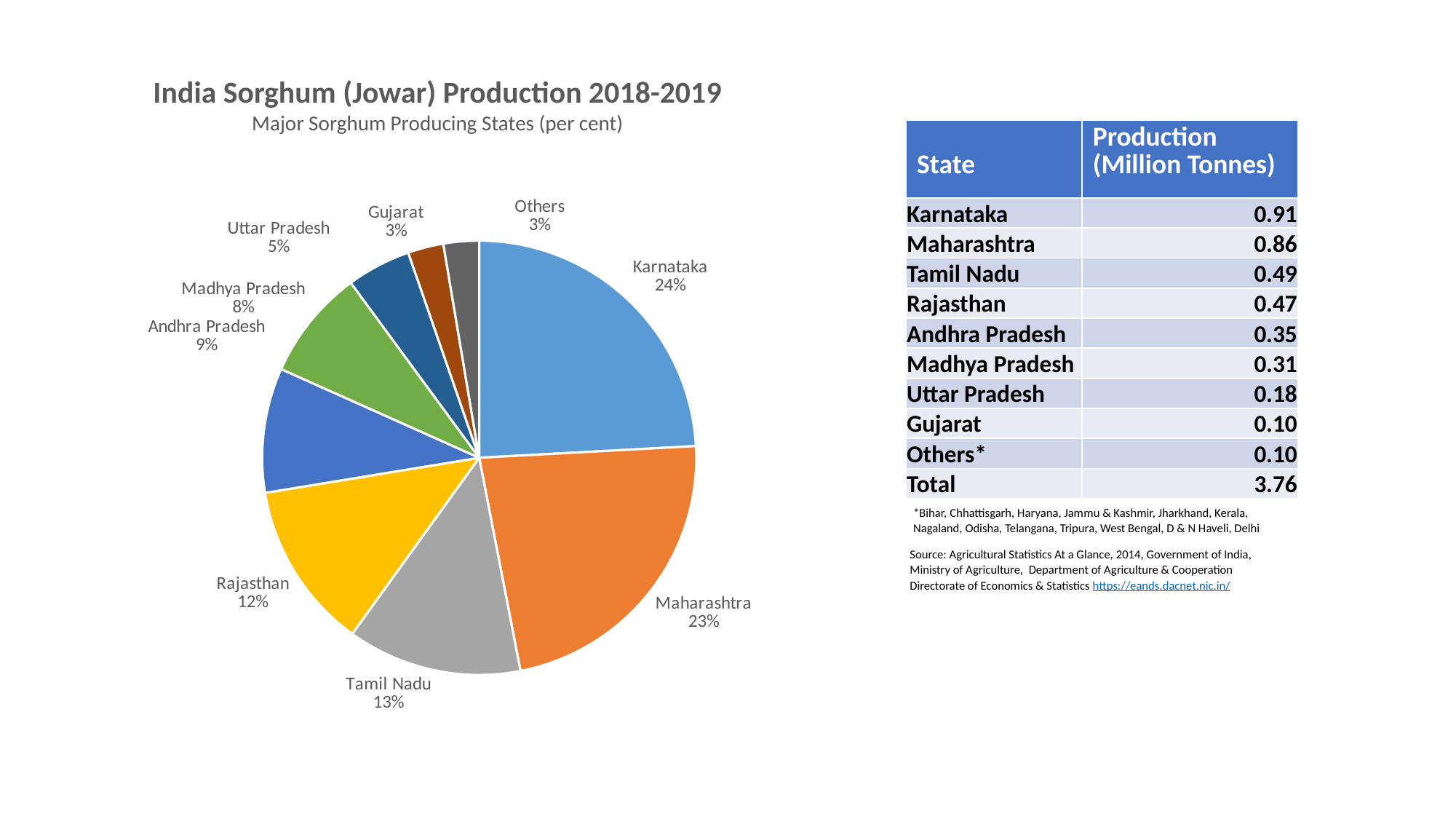
What is the difference in percentage points between Rajasthan and Uttar Pradesh? 7% What is the difference in percentage points between Karnataka and Maharashtra? 1% What share of the pie does Maharashtra hold? 23% Which is larger, the share for Madhya Pradesh or the share for Andhra Pradesh? Andhra Pradesh What percentage is shown for Andhra Pradesh? 9% What percentage is shown for Rajasthan? 12% How many slices does the pie chart have? 9 What kind of chart is shown on the slide? Pie chart Which state has the largest slice of the pie? Karnataka What is the title of the chart? India Sorghum (Jowar) Production 2018-2019 What percentage is shown for Tamil Nadu? 13% What share of the pie does Karnataka hold? 24%